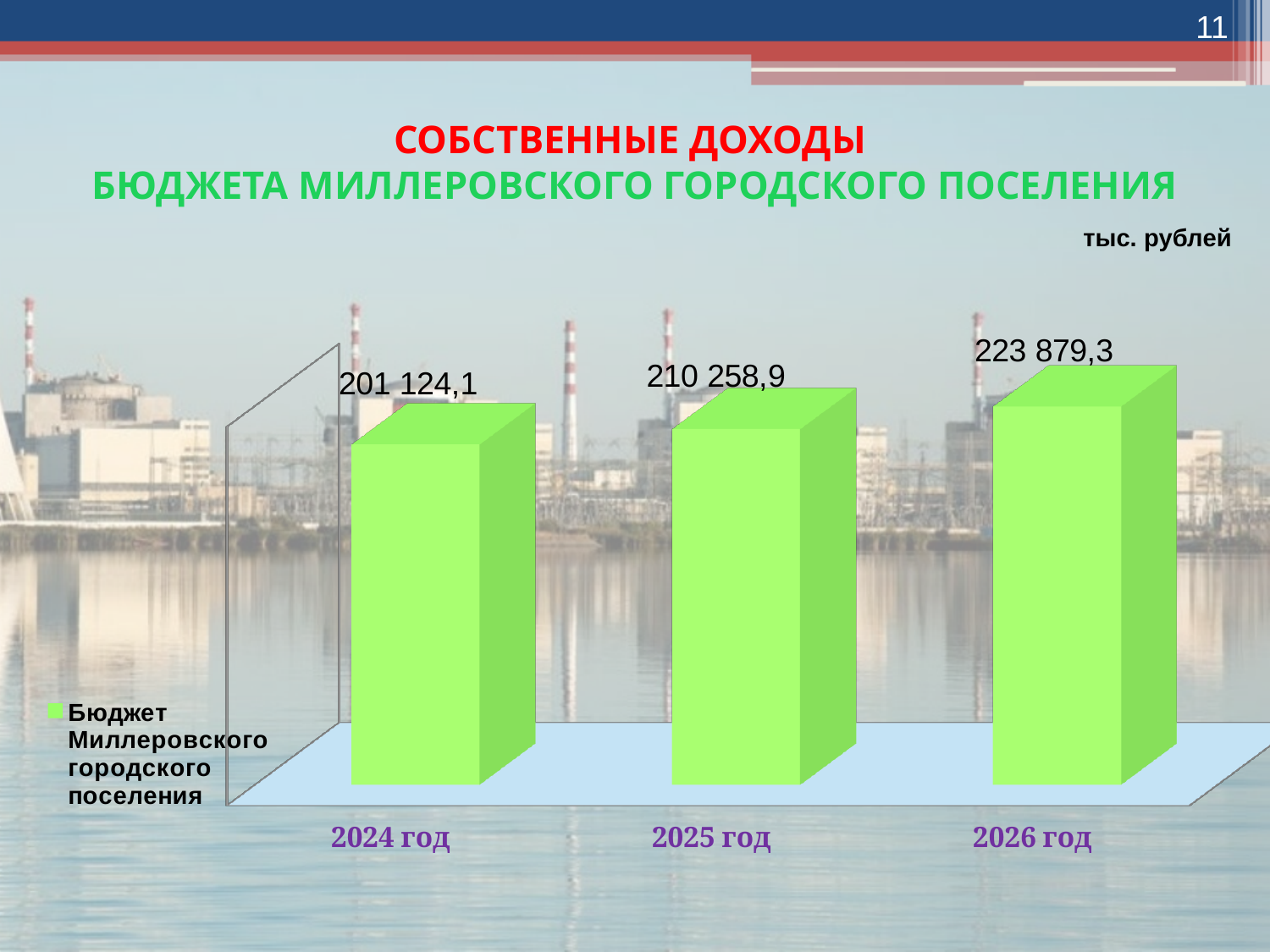
What is the difference between the values for 2026 год and 2025 год? 13 620,4 Do the values rise or fall from 2024 год to 2026 год? Rise What is the value for 2024 год? 201 124,1 Which year has the lowest value? 2024 год How many years are shown in the chart? 3 What is the difference between the values for 2025 год and 2024 год? 9 134,8 What is the value for 2025 год? 210 258,9 Which year has the highest value? 2026 год Which is larger, the value for 2024 год or the value for 2026 год? 2026 год What is the value for 2026 год? 223 879,3 What kind of chart is shown on the slide? Bar chart How many series does the legend list? 1